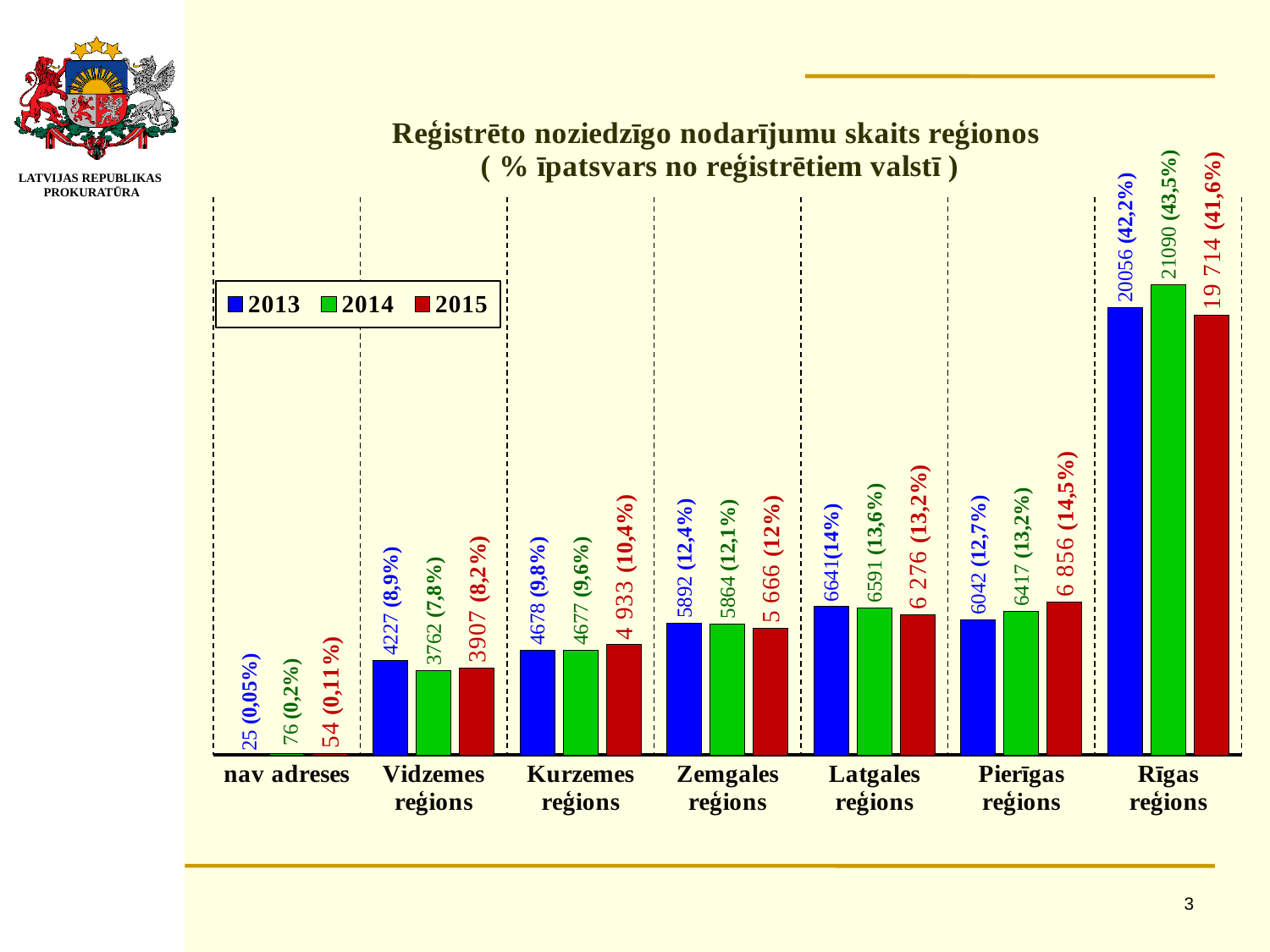
What percentage share is printed for Latgales reģions in 2013? 14% Which series is shown in red in the legend? 2015 What is the 2015 value for Kurzemes reģions? 4 933 What kind of chart is shown on the slide? bar chart What is the 2014 value for Rīgas reģions? 21090 What is the difference between the 2013 and 2015 values for Pierīgas reģions? 814 What is the 2013 value for nav adreses? 25 Which category has the highest value in 2015? Rīgas reģions Which category has the lowest value in 2014? nav adreses How many series does the legend list? 3 How many categories are shown on the x axis? 7 Which is larger for Vidzemes reģions, the 2013 value or the 2014 value? 2013